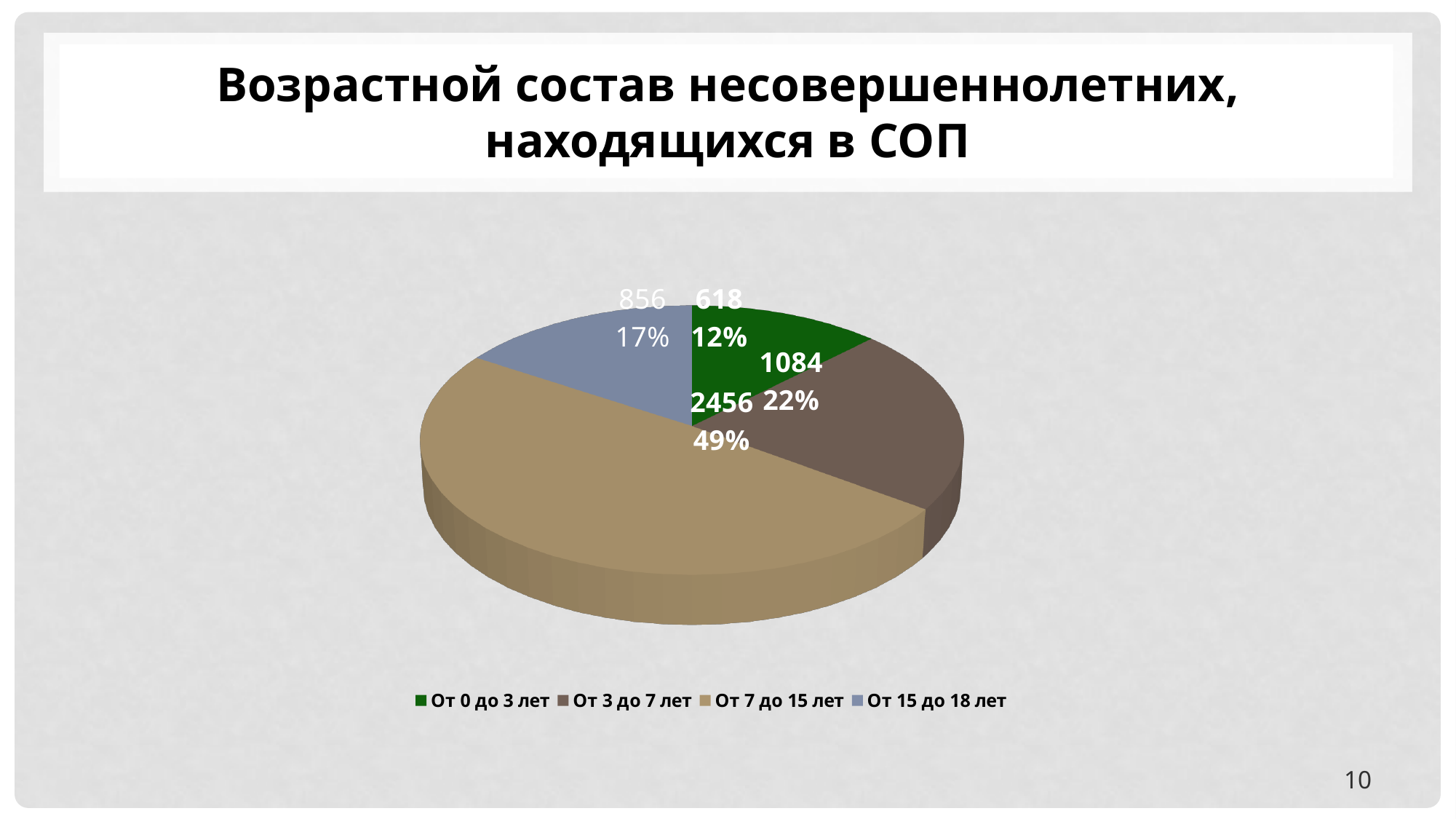
How many categories does the pie chart have? 4 What is the difference between the values for "От 7 до 15 лет" and "От 3 до 7 лет"? 1372 What percentage share does the slice "От 7 до 15 лет" have? 49% What percentage share does the slice "От 3 до 7 лет" have? 22% What is the value for the category "От 15 до 18 лет"? 856 What kind of chart is shown on the slide? pie chart What is the value for the category "От 7 до 15 лет"? 2456 Which is larger, the value for "От 15 до 18 лет" or the value for "От 3 до 7 лет"? От 3 до 7 лет Which category has the smallest slice? От 0 до 3 лет What is the value for the category "От 0 до 3 лет"? 618 Which category has the largest slice? От 7 до 15 лет What is the title of the chart on the slide? Возрастной состав несовершеннолетних, находящихся в СОП